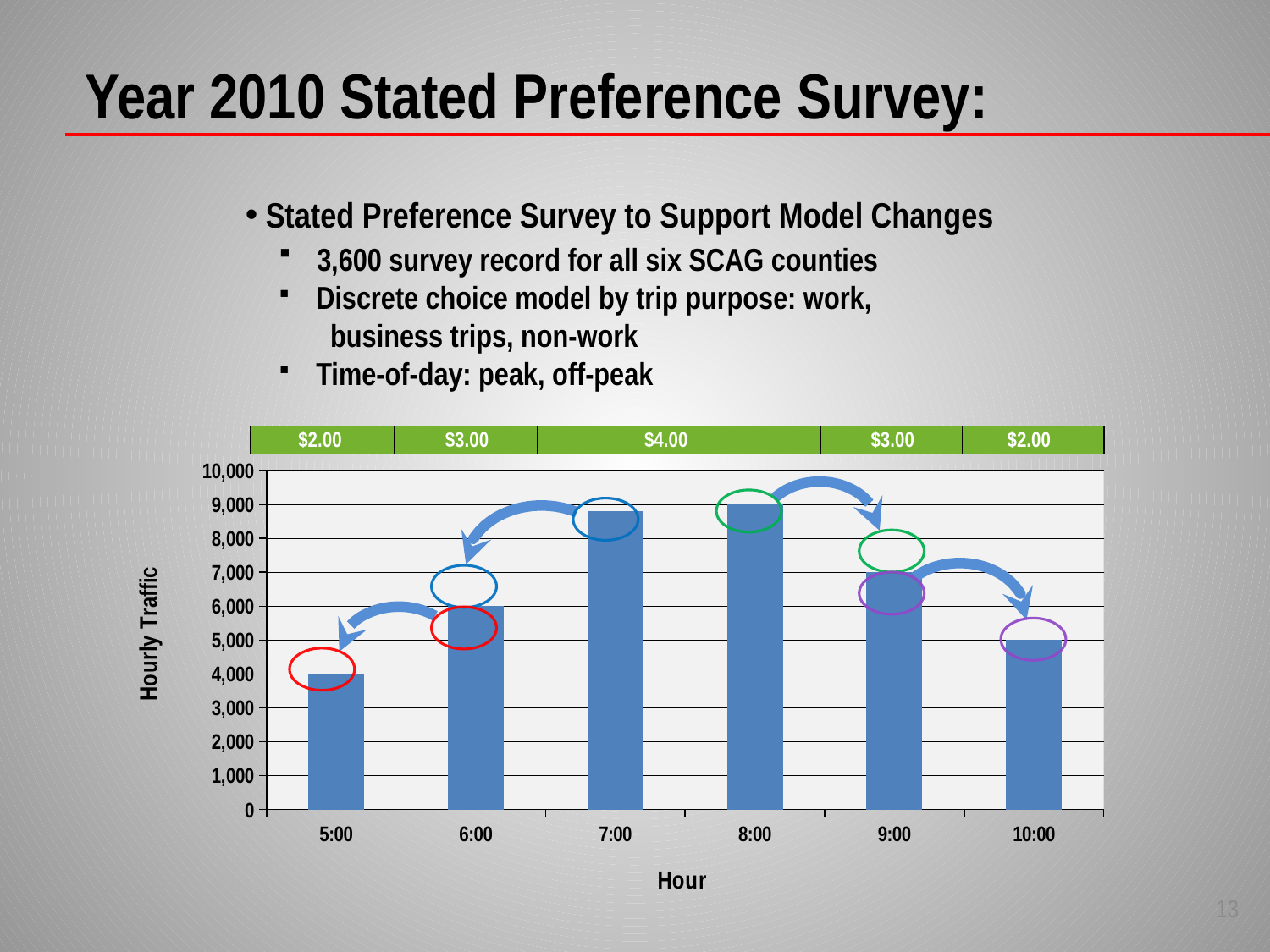
What kind of chart is shown on the slide? bar chart Which hour has the lowest hourly traffic? 5:00 What toll price is shown in the green band above the 7:00 and 8:00 bars? $4.00 Is the hourly traffic value for 7:00 greater or less than 8,000? greater Which hour has higher hourly traffic, 9:00 or 10:00? 9:00 What is the hourly traffic value for 5:00? 4,000 How many hours are shown on the x axis of the chart? 6 What is the hourly traffic value for 8:00? 9,000 What is the hourly traffic value for 6:00? 6,000 What is the hourly traffic value for 9:00? 7,000 Does hourly traffic rise or fall from 8:00 to 10:00? fall What is the difference in hourly traffic between 6:00 and 5:00? 2,000